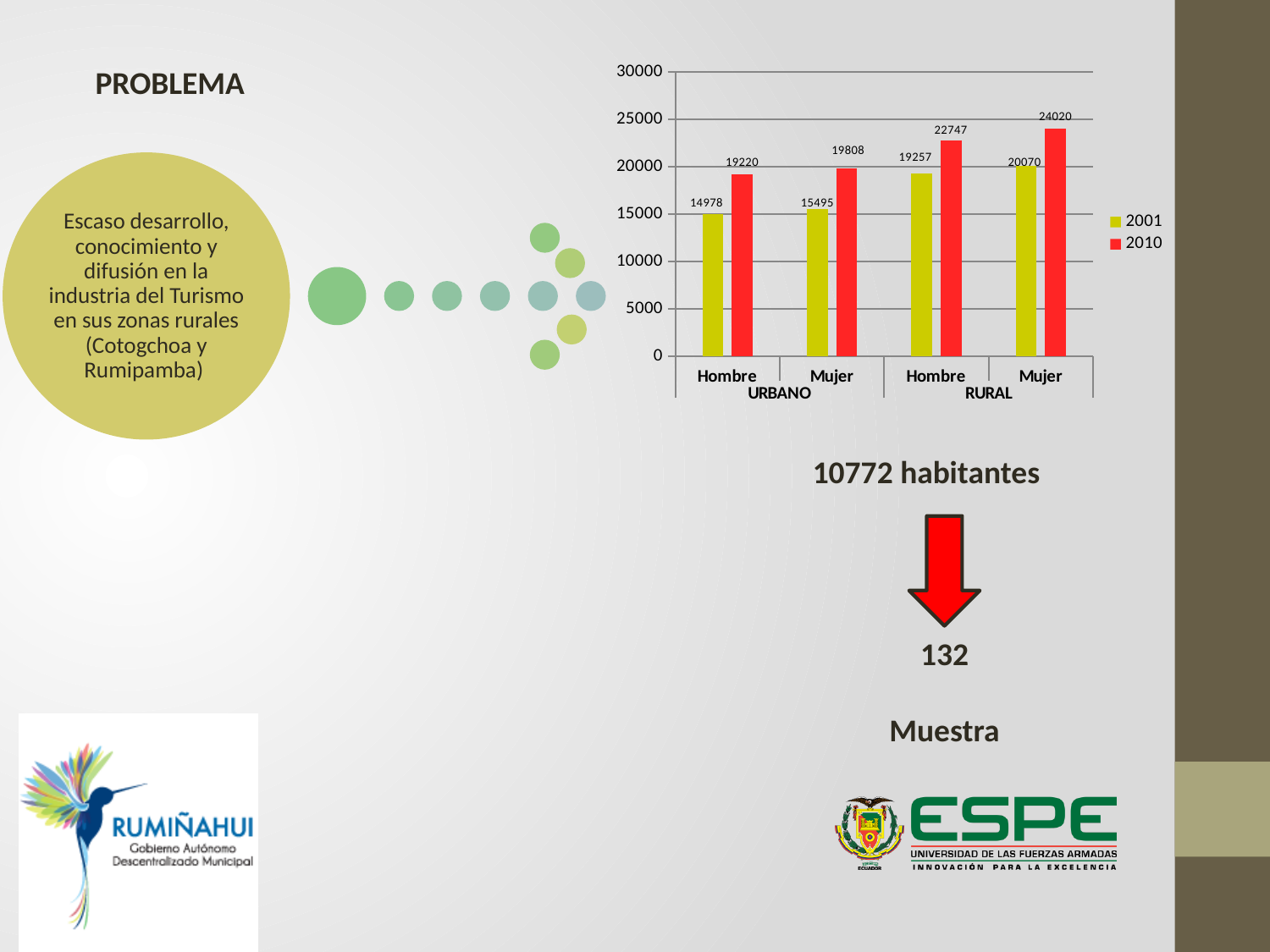
What is the difference between the 2010 and 2001 values for Hombre in the RURAL group? 3490 What is the 2010 value for Mujer in the URBANO group? 19808 Which colour represents the 2010 series in the chart? Red Which is larger: the 2001 value for Mujer in the RURAL group or the 2010 value for Hombre in the URBANO group? 2001 value for Mujer in the RURAL group How many categories are shown on the x axis? 4 What is the 2001 value for Hombre in the RURAL group? 19257 What is the 2010 value for Mujer in the RURAL group? 24020 Which category has the lowest 2001 value? URBANO Hombre What kind of chart is shown on the slide? Bar chart How many series does the legend list? 2 What is the 2001 value for Hombre in the URBANO group? 14978 Which category has the highest 2010 value? RURAL Mujer